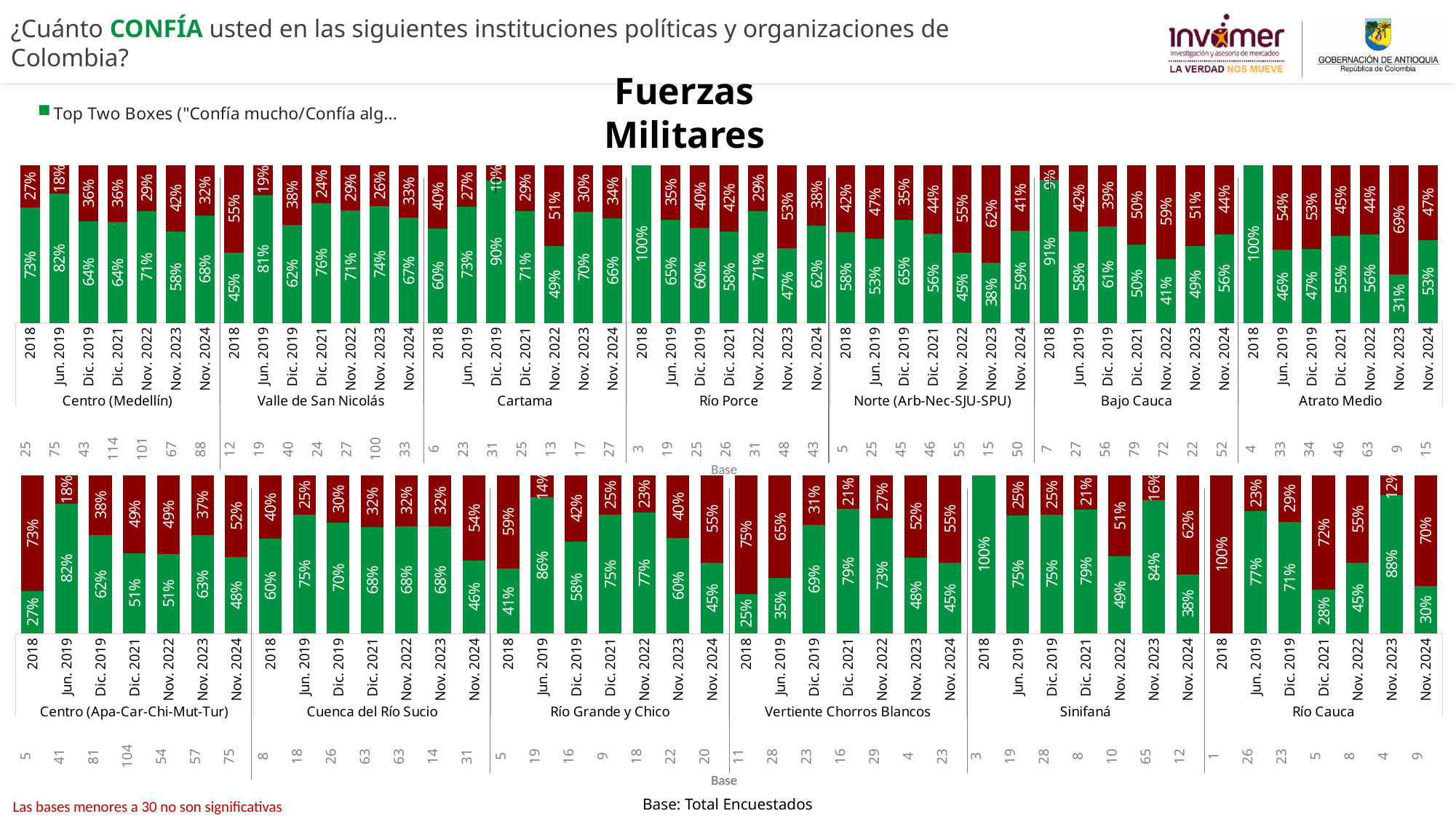
In the top chart, how many periods are shown for each region? 7 How many regions are shown in the bottom chart? 6 In the bottom chart, which period has the lowest Top Two Boxes value within Vertiente Chorros Blancos? 2018 In the top chart, what is the base (number of respondents) for Centro (Medellín) in Dic. 2021? 114 In the top chart, what is the Top Two Boxes value for Centro (Medellín) in Nov. 2024? 68% In the bottom chart, which is larger: the Top Two Boxes value for Río Grande y Chico in Jun. 2019 or in Nov. 2024? Jun. 2019 In the top chart, which period has the highest Top Two Boxes value within Cartama? Dic. 2019 In the top chart, what is the Top Two Boxes value for Atrato Medio in Nov. 2023? 31% In the bottom chart, what is the Top Two Boxes value for Sinifaná in Nov. 2023? 84% What kind of chart is used on this slide? Stacked bar chart In the top chart, what is the difference between the Top Two Boxes values for Valle de San Nicolás in Jun. 2019 and 2018? 36% In the bottom chart, what is the Top Two Boxes value for Río Cauca in Dic. 2021? 28%